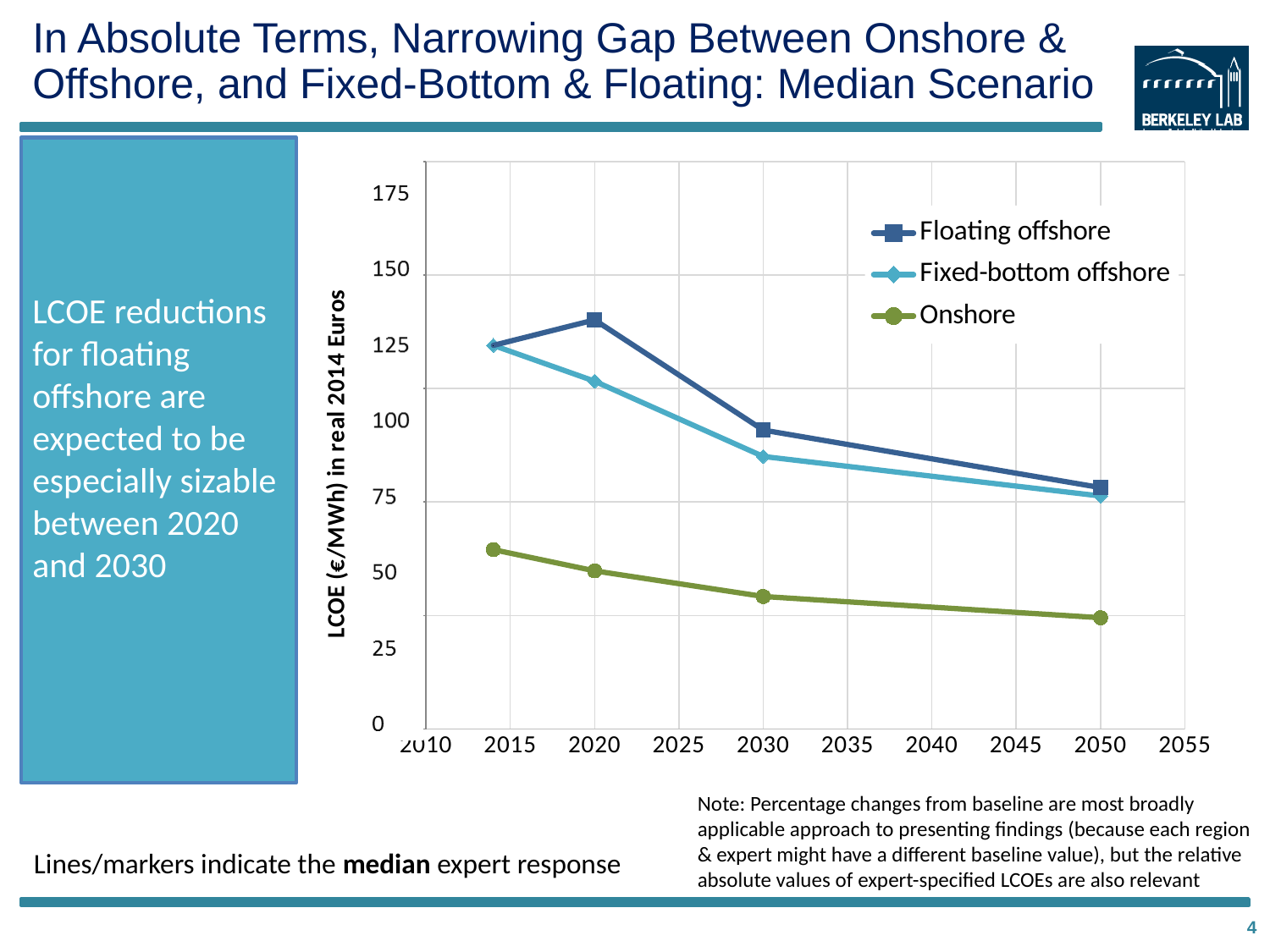
Is the Onshore value in 2020 greater or less than 75? less Does the Onshore line rise or fall from 2015 to 2050? fall Which series has the highest value in 2020? Floating offshore Is the Floating offshore value in 2020 greater or less than 125? greater Is the Onshore value in 2050 greater or less than 25? greater What is the label of the chart's vertical axis? LCOE (€/MWh) in real 2014 Euros What kind of chart is shown on the slide? line chart In 2030, which is larger: the Floating offshore value or the Onshore value? Floating offshore How many series does the chart's legend list? 3 Which series has the lowest value in 2050? Onshore What are the three series named in the chart's legend? Floating offshore, Fixed-bottom offshore, Onshore